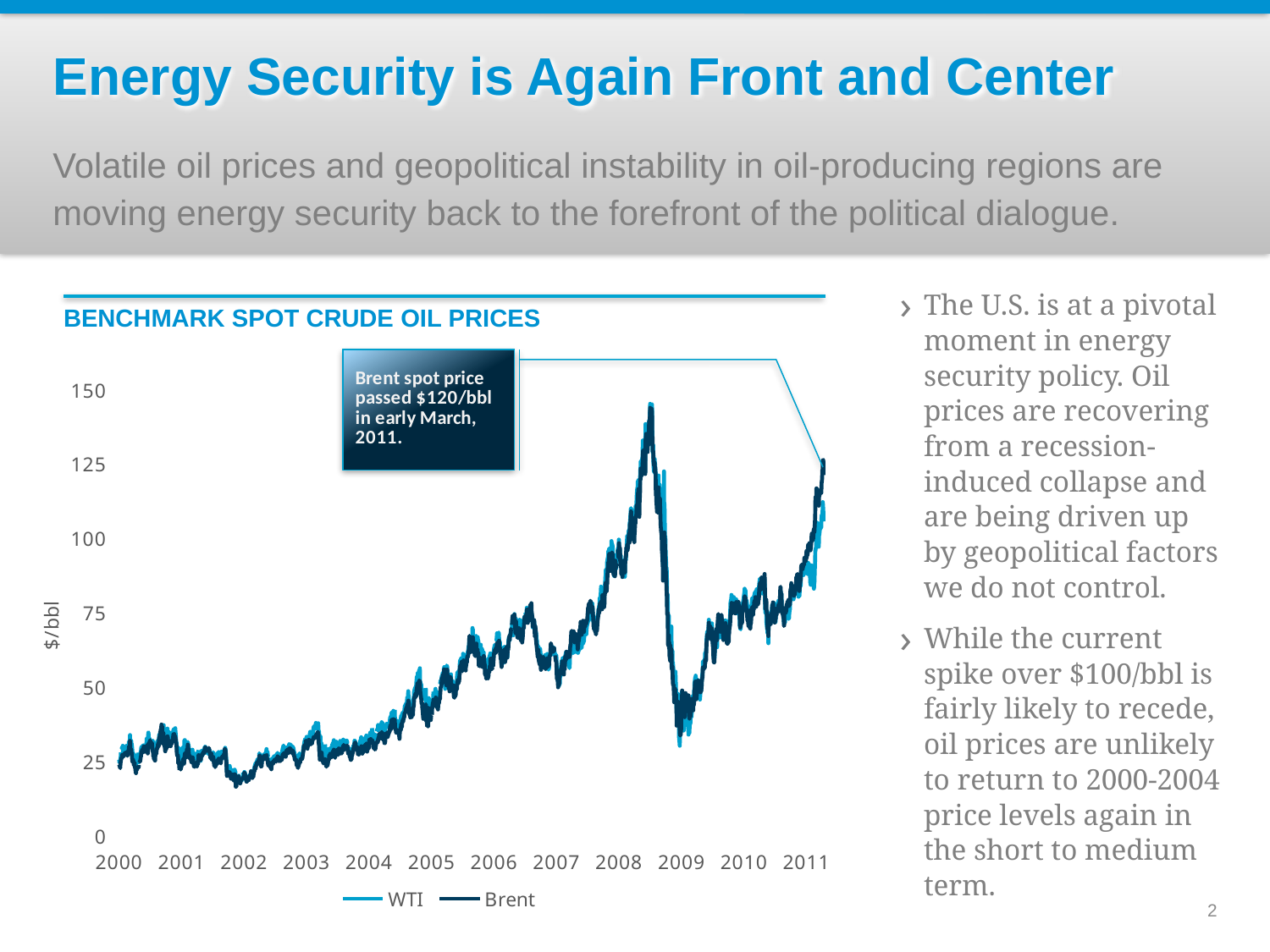
Is the lowest Brent spot price in early 2009 greater or less than 50 $/bbl? less Is the Brent spot price at the start of 2000 greater or less than 50 $/bbl? less How many year labels appear along the x axis of the crude oil price chart? 12 What are the two series named in the legend of the crude oil price chart? WTI and Brent What is the label on the vertical axis of the crude oil price chart? $/bbl Do crude oil prices rise or fall between mid-2008 and early 2009 on the chart? fall Do crude oil prices generally rise or fall between 2002 and mid-2008 on the chart? rise What kind of chart is shown under the title 'BENCHMARK SPOT CRUDE OIL PRICES'? Line chart Is the peak Brent spot price reached in 2008 greater or less than 125 $/bbl? greater According to the annotation on the chart, what price level did the Brent spot price pass in early March 2011? $120/bbl How many series does the legend of the crude oil price chart list? 2